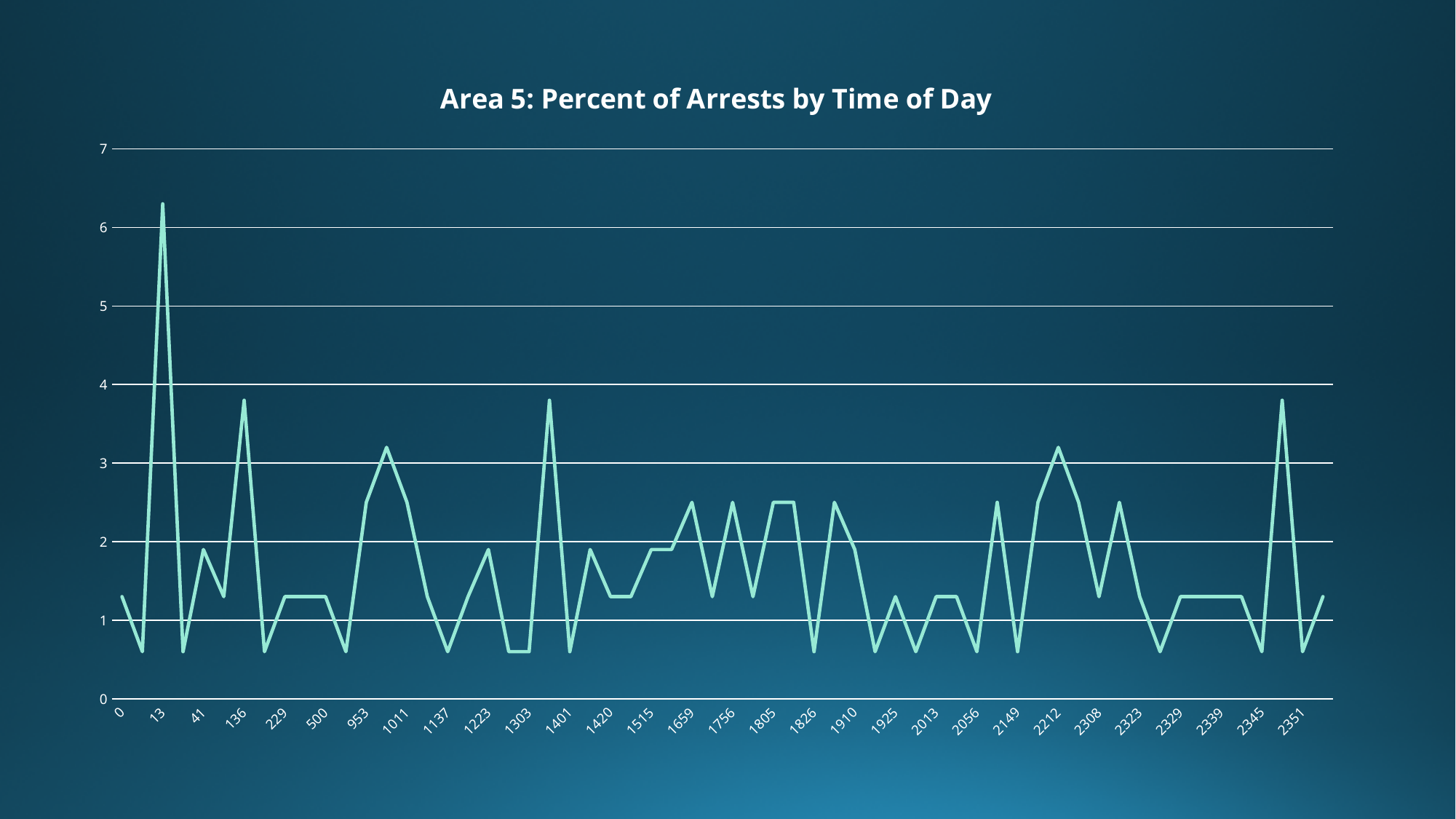
Is the value at time 136 greater or less than 3? greater What is the maximum value shown on the vertical axis? 7 Is the value at time 2149 greater or less than 2? less Is the value at time 2212 greater or less than 2? greater Which has the larger value, time 13 or time 136? 13 Which time label has the highest value on the chart? 13 Which has the larger value, time 136 or time 1925? 136 What kind of chart is shown on the slide? line chart What is the title of the chart? Area 5: Percent of Arrests by Time of Day